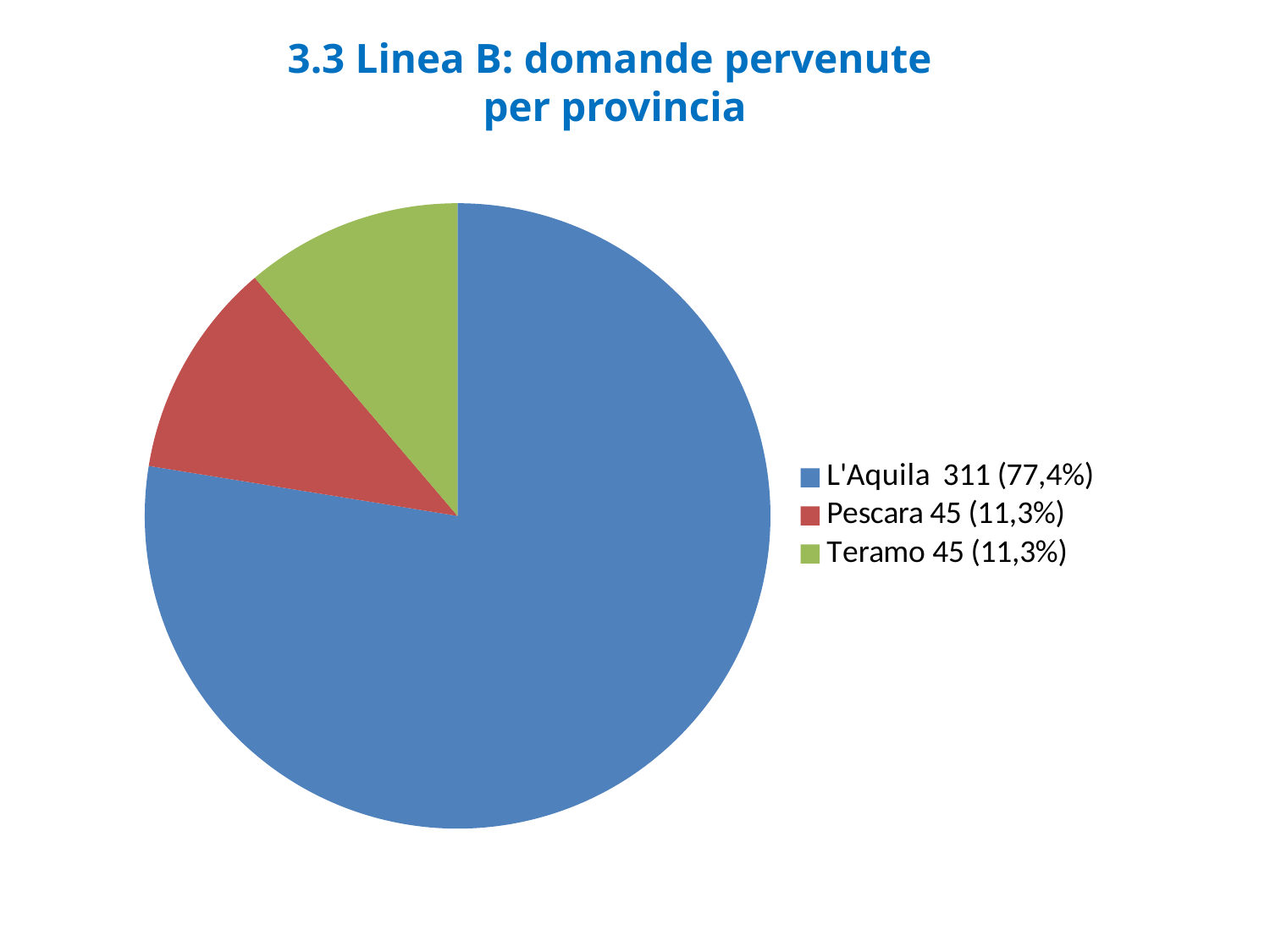
What percentage share of the pie does L'Aquila have? 77,4% Which colour represents Pescara in the pie chart? red Which province has the largest slice of the pie? L'Aquila How many domande pervenute are shown for Pescara? 45 How many slices does the pie chart have? 3 Which is larger, the value for L'Aquila or the value for Teramo? L'Aquila What percentage share of the pie does Teramo have? 11,3% What kind of chart is shown on the slide? pie chart What is the difference between the number of domande for L'Aquila and for Pescara? 266 How many domande pervenute are shown for L'Aquila? 311 What is the title of the chart? 3.3 Linea B: domande pervenute per provincia How many entries does the legend list? 3